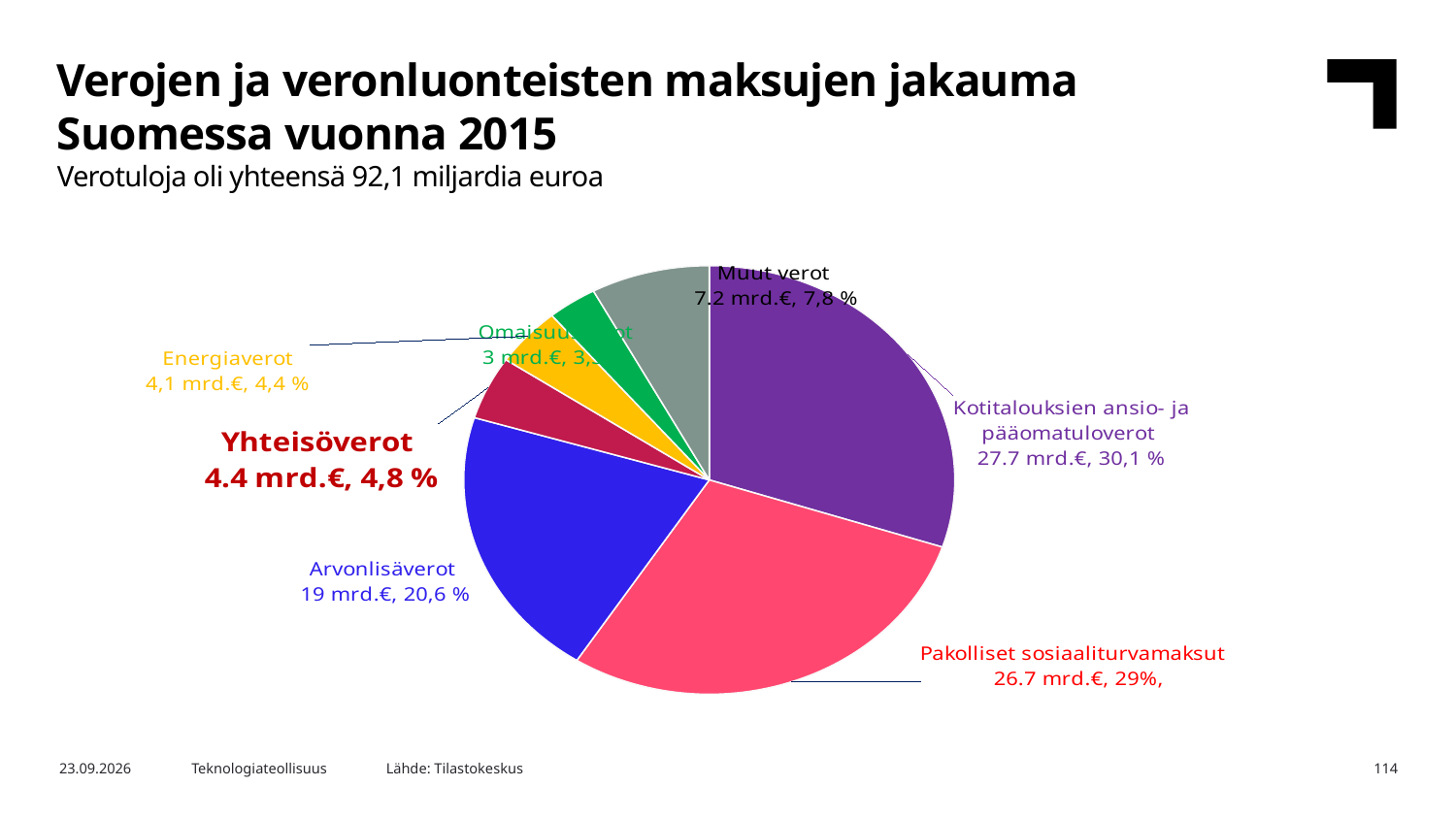
Which is larger, Arvonlisäverot or Muut verot? Arvonlisäverot What percentage share is shown for Kotitalouksien ansio- ja pääomatuloverot? 30,1 % What percentage share is shown for Energiaverot? 4,4 % What percentage share is shown for Muut verot? 7,8 % What is the title of the chart slide? Verojen ja veronluonteisten maksujen jakauma Suomessa vuonna 2015 How many slices does the pie chart have? 7 What kind of chart is shown on the slide? Pie chart What is the difference in mrd.€ between Kotitalouksien ansio- ja pääomatuloverot and Pakolliset sosiaaliturvamaksut? 1 mrd.€ What value in mrd.€ is shown for Arvonlisäverot? 19 mrd.€ What value in mrd.€ is shown for Yhteisöverot? 4.4 mrd.€ What value in mrd.€ is shown for Pakolliset sosiaaliturvamaksut? 26.7 mrd.€ Which category has the largest share of the pie? Kotitalouksien ansio- ja pääomatuloverot